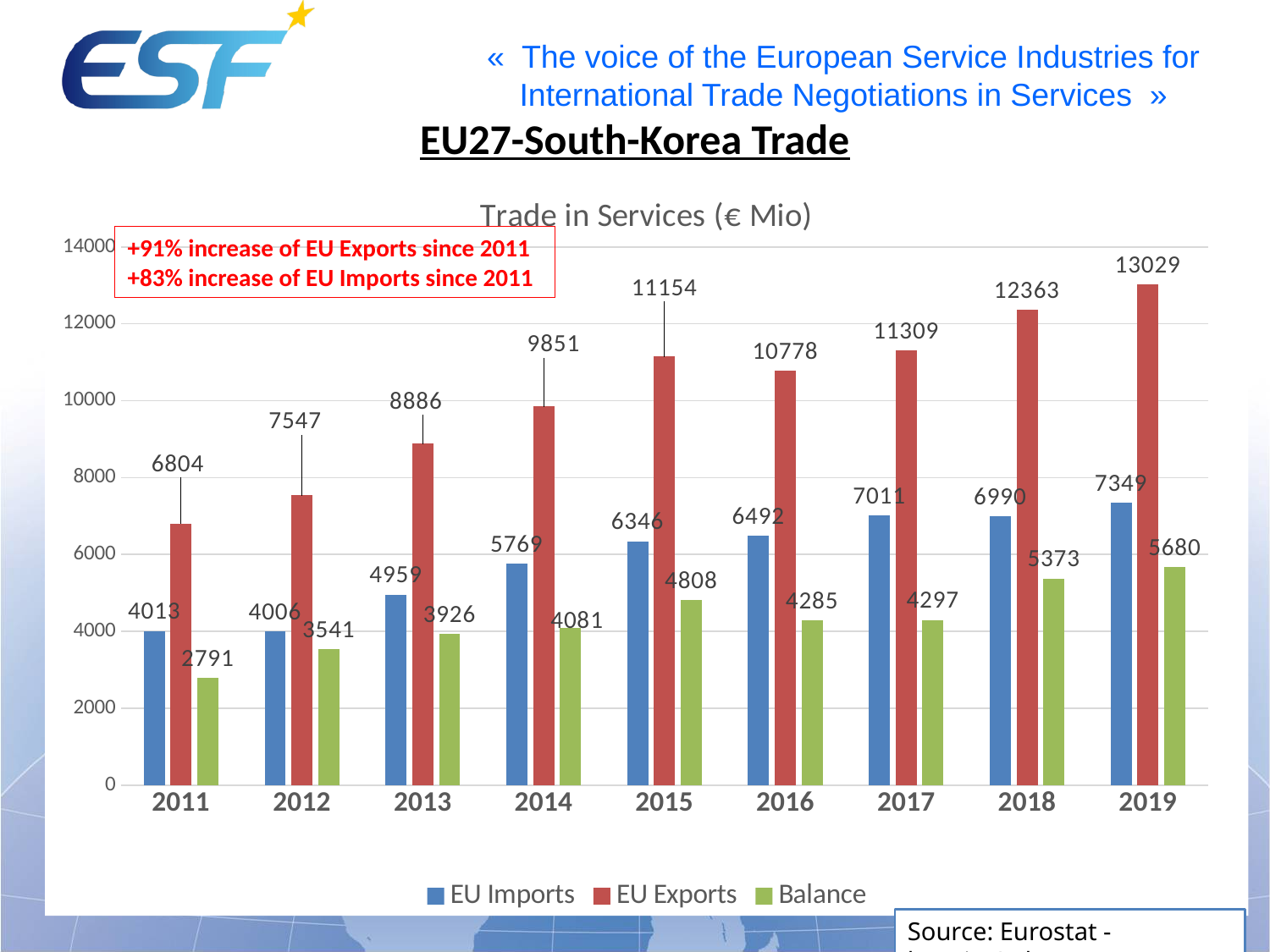
Which year has the larger EU Exports value, 2015 or 2016? 2015 In which year is the Balance lowest? 2011 What kind of chart is shown on the slide? Bar chart How many years are shown on the x axis? 9 What is the value of EU Imports in 2011? 4013 What is the difference between EU Exports and EU Imports in 2019? 5680 What is the Balance value for 2015? 4808 How many series does the legend list? 3 By how much did the Balance increase from 2011 to 2019? 2889 In which year are EU Exports highest? 2019 What is the value of EU Exports in 2019? 13029 Do EU Exports rise or fall from 2011 to 2014? Rise